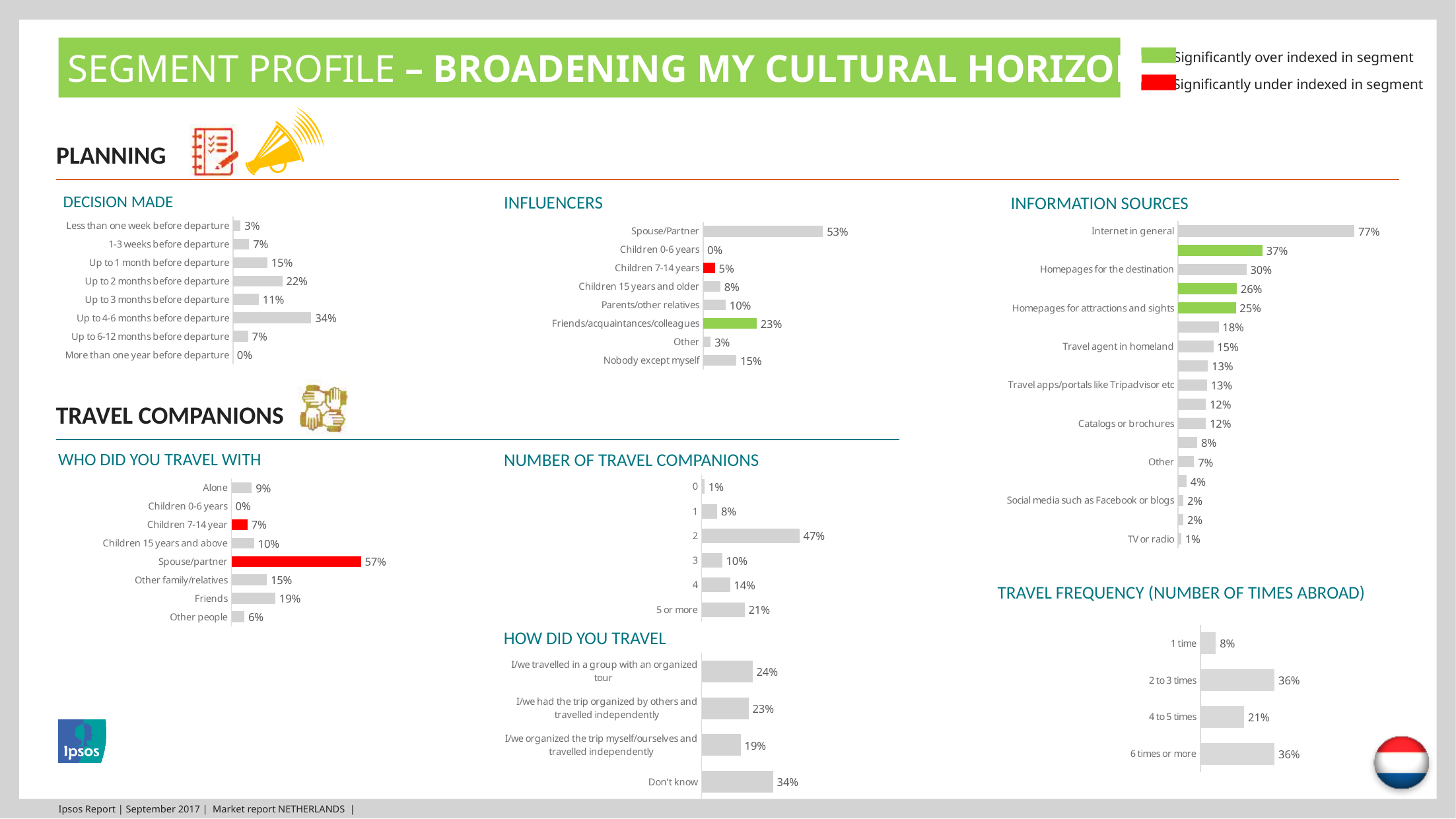
In the INFORMATION SOURCES chart, what is the value for 'Internet in general'? 77% What type of chart is the TRAVEL FREQUENCY (NUMBER OF TIMES ABROAD) chart? Bar chart In the INFORMATION SOURCES chart, which is larger: 'Homepages for the destination' or 'Travel agent in homeland'? Homepages for the destination In the WHO DID YOU TRAVEL WITH chart, which category has the highest value? Spouse/partner In the HOW DID YOU TRAVEL chart, what is the value for 'Don't know'? 34% In the TRAVEL FREQUENCY (NUMBER OF TIMES ABROAD) chart, what is the difference between '2 to 3 times' and '4 to 5 times'? 15% In the INFLUENCERS chart, what is the value for 'Friends/acquaintances/colleagues'? 23% In the DECISION MADE chart, what is the value for 'Up to 4-6 months before departure'? 34% In the WHO DID YOU TRAVEL WITH chart, how many categories are shown? 8 In the DECISION MADE chart, which category has the highest value? Up to 4-6 months before departure In the NUMBER OF TRAVEL COMPANIONS chart, what is the value for '2'? 47% In the INFLUENCERS chart, what is the difference between 'Spouse/Partner' and 'Nobody except myself'? 38%